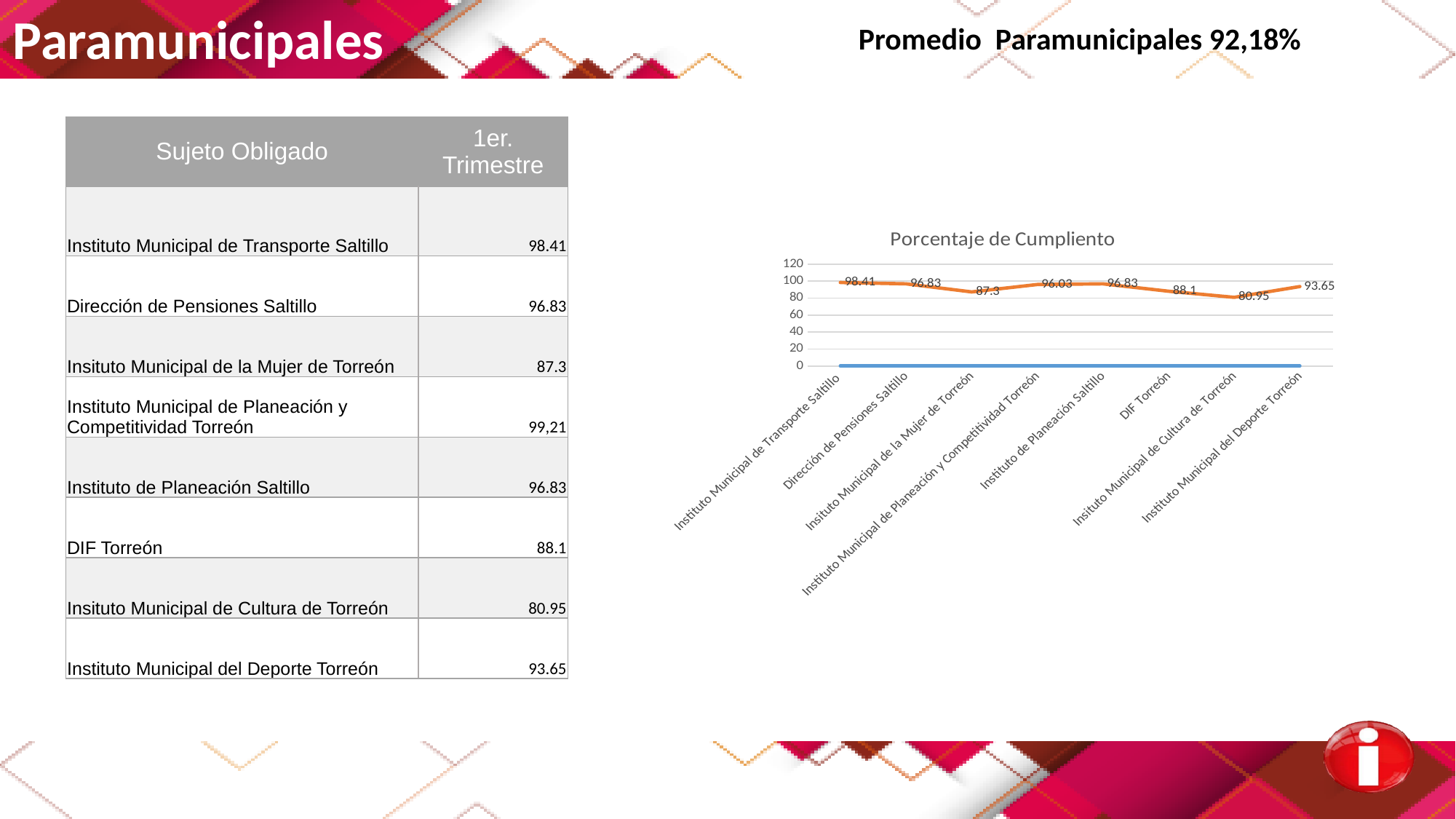
How many categories are plotted along the x axis of the chart? 8 What is the value shown for Instituto Municipal de Transporte Saltillo in the chart? 98.41 Is the value for Insituto Municipal de Cultura de Torreón in the chart greater or less than 100? less What is the value shown for Instituto Municipal del Deporte Torreón in the chart? 93.65 What is the value shown for Insituto Municipal de la Mujer de Torreón in the chart? 87.3 What is the value shown for DIF Torreón in the chart? 88.1 Which category has the lowest value in the chart? Insituto Municipal de Cultura de Torreón What is the title of the chart? Porcentaje de Cumpliento Which has a larger value in the chart, DIF Torreón or Instituto Municipal del Deporte Torreón? Instituto Municipal del Deporte Torreón What is the difference between the values for Instituto Municipal de Transporte Saltillo and Insituto Municipal de Cultura de Torreón in the chart? 17.46 What kind of chart is shown on the slide? line chart Which category has the highest value in the chart? Instituto Municipal de Transporte Saltillo